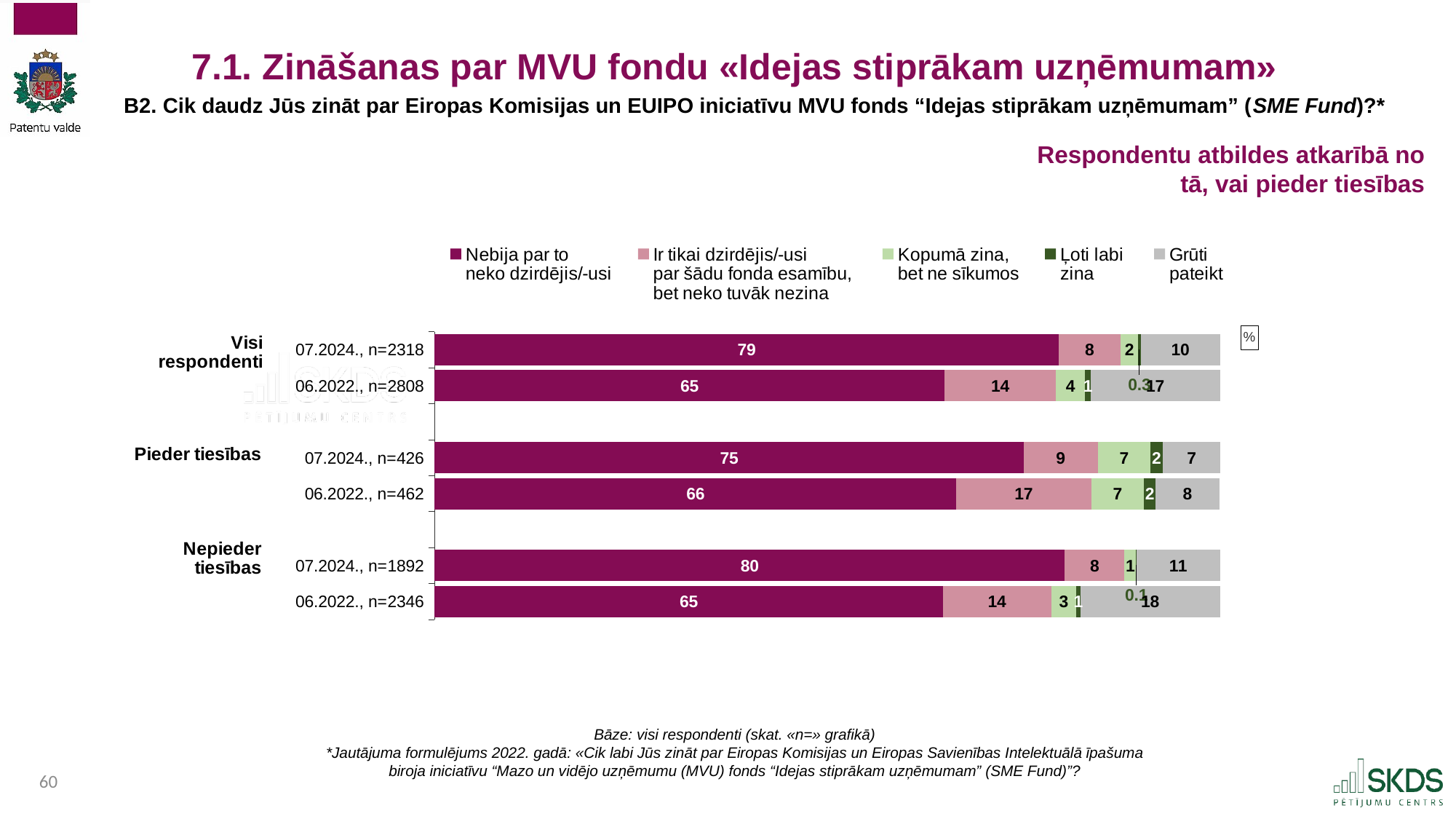
What is the sample size (n) shown for Pieder tiesības, 07.2024? n=426 What is the value of "Grūti pateikt" for Nepieder tiesības, 06.2022? 18 What is the value of "Kopumā zina, bet ne sīkumos" for Pieder tiesības, 07.2024? 7 For Pieder tiesības, is "Ir tikai dzirdējis/-usi par šādu fonda esamību, bet neko tuvāk nezina" larger in 07.2024 or 06.2022? 06.2022 What is the value of "Grūti pateikt" for Visi respondenti, 07.2024? 10 Which bar has the lowest value for "Grūti pateikt"? Pieder tiesības, 07.2024 (7) What is the value of "Nebija par to neko dzirdējis/-usi" for Pieder tiesības, 07.2024? 75 How many bars are plotted in the chart? 6 Which bar has the highest value for "Nebija par to neko dzirdējis/-usi"? Nepieder tiesības, 07.2024 (80) What kind of chart is shown on the slide? Stacked bar chart How many series does the legend list? 5 What is the difference in "Nebija par to neko dzirdējis/-usi" between Visi respondenti 07.2024 and 06.2022? 14